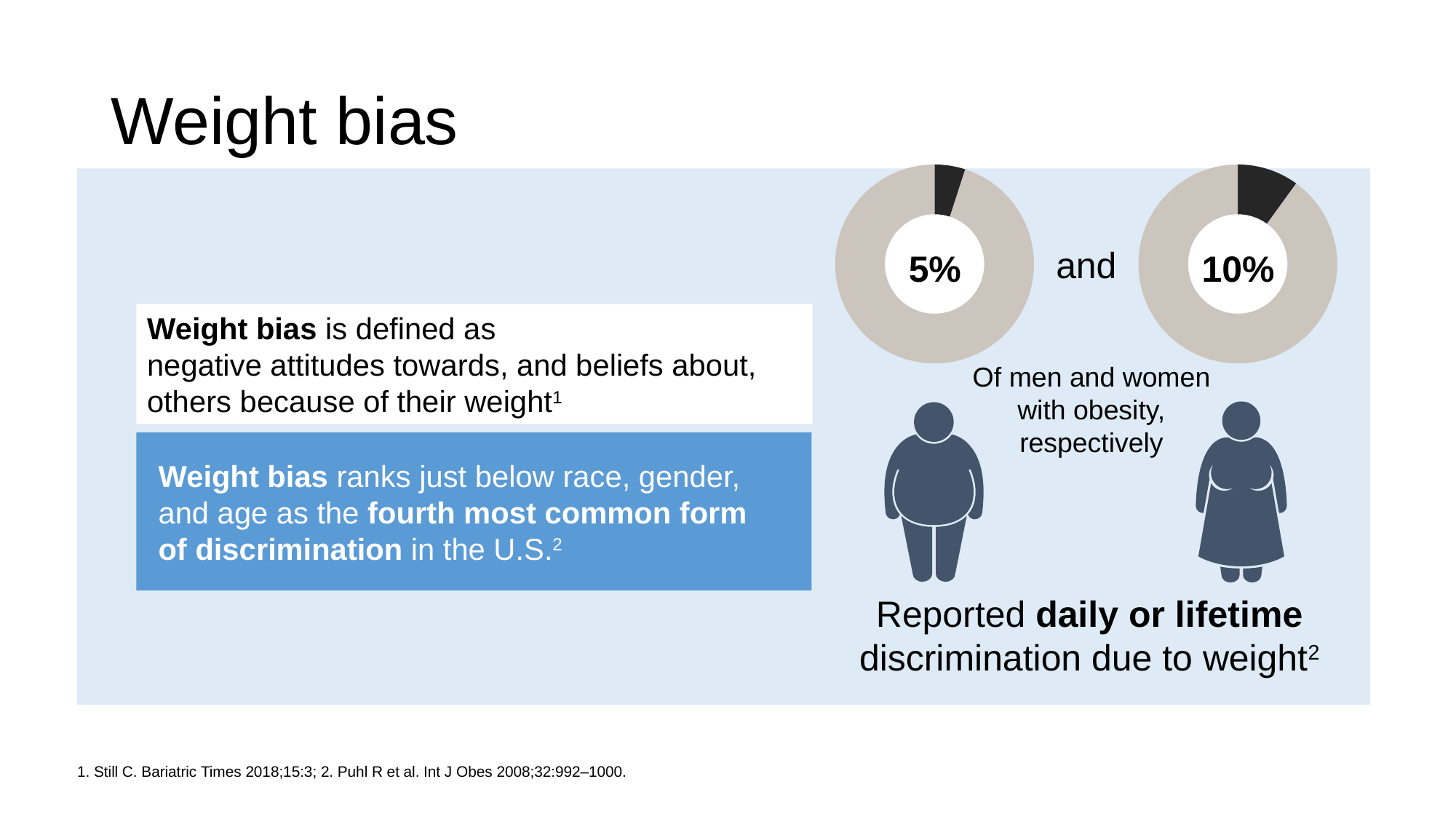
Is the value shown in the right donut chart greater or less than 5%? Greater What colour is the highlighted segment in each donut chart? Black How many donut charts are on the slide? 2 Which group shows the lower percentage in the donut charts, men or women? Men What kind of chart is used to show the 5% and 10% values? Donut chart What value is shown in the centre of the left donut chart? 5% What value is shown in the centre of the right donut chart? 10% According to the donut charts, what percentage of women with obesity reported daily or lifetime discrimination due to weight? 10% What is the difference between the percentage shown for women and the percentage shown for men in the donut charts? 5 percentage points What do the two donut charts represent, according to the caption below them? Reported daily or lifetime discrimination due to weight Which group shows the higher percentage in the donut charts, men or women? Women According to the donut charts, what percentage of men with obesity reported daily or lifetime discrimination due to weight? 5%